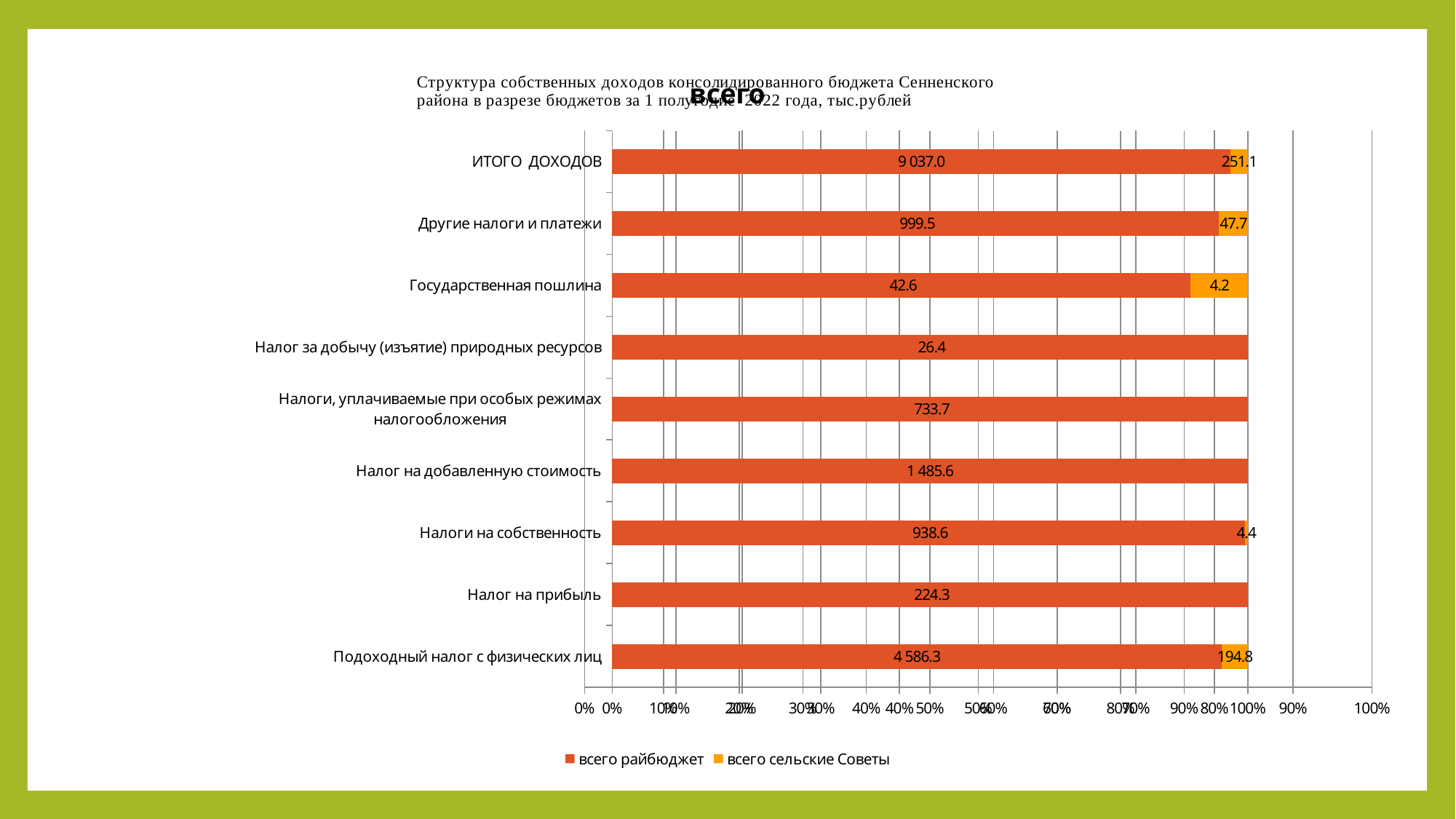
How many categories are shown on the chart? 9 What is the difference between the всего райбюджет and всего сельские Советы values for Другие налоги и платежи? 951.8 What kind of chart is shown on the slide? Stacked bar chart How many series does the legend list? 2 Which category has the highest value for всего райбюджет? ИТОГО ДОХОДОВ What is the value for всего сельские Советы for Подоходный налог с физических лиц? 194.8 What is the total of the stacked bar for Государственная пошлина? 46.8 What is the value for всего райбюджет for ИТОГО ДОХОДОВ? 9 037.0 Which category has the lowest value for всего райбюджет? Налог за добычу (изъятие) природных ресурсов Which is larger for всего райбюджет: Налог на добавленную стоимость or Налоги на собственность? Налог на добавленную стоимость What is the value for всего сельские Советы for Государственная пошлина? 4.2 What is the value for всего райбюджет for Налог на добавленную стоимость? 1 485.6